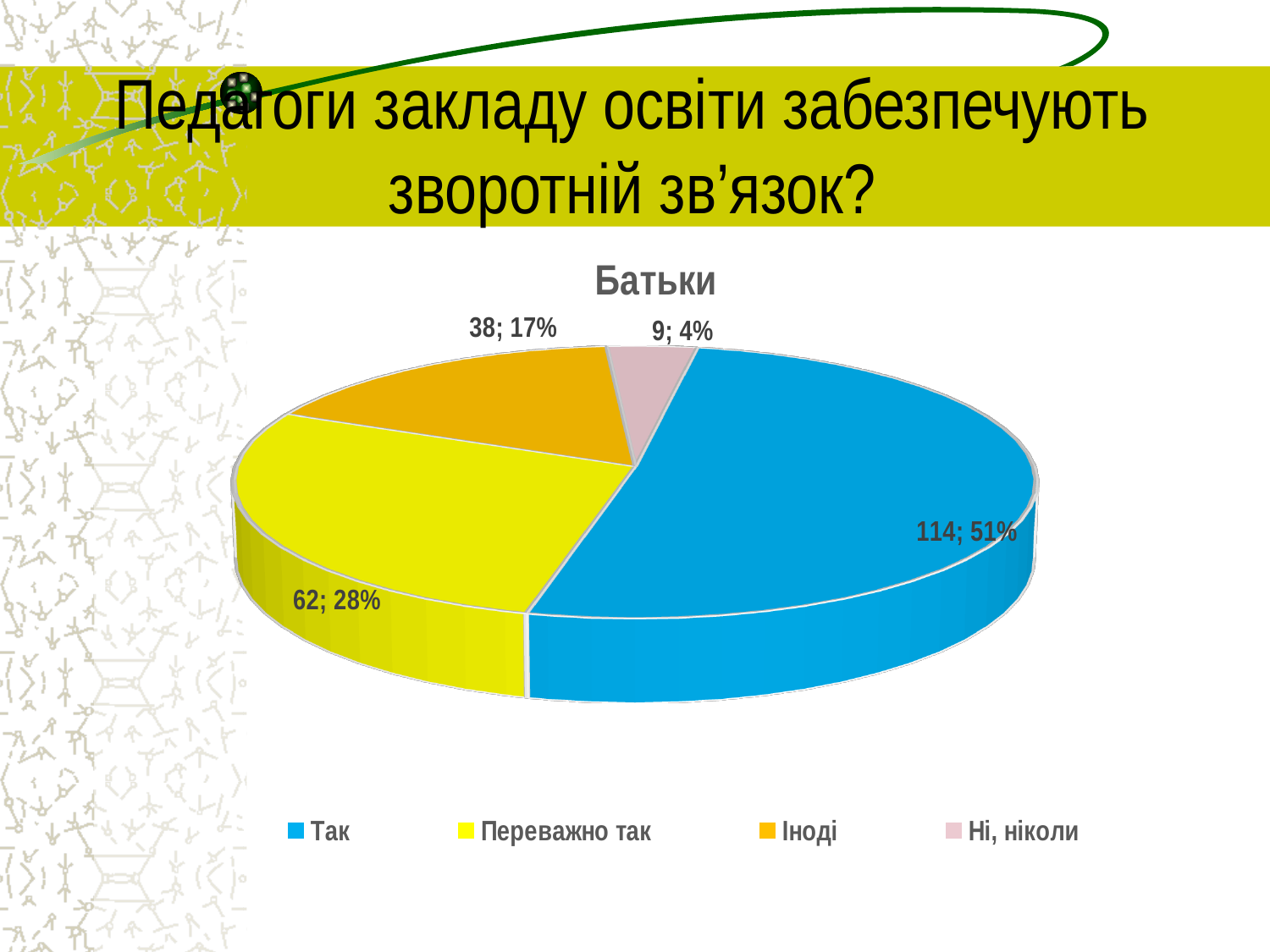
What is the count for the 'Так' slice? 114 What colour is the 'Так' slice? blue What kind of chart is shown on the slide? pie chart Which is larger, the count for 'Іноді' or the count for 'Ні, ніколи'? Іноді What is the title of the chart? Батьки What percentage share does the 'Переважно так' slice have? 28% Which category has the smallest slice? Ні, ніколи Which category has the largest slice? Так What percentage share does the 'Ні, ніколи' slice have? 4% What is the count for the 'Іноді' slice? 38 How many categories does the legend list? 4 What is the difference between the counts for 'Так' and 'Переважно так'? 52